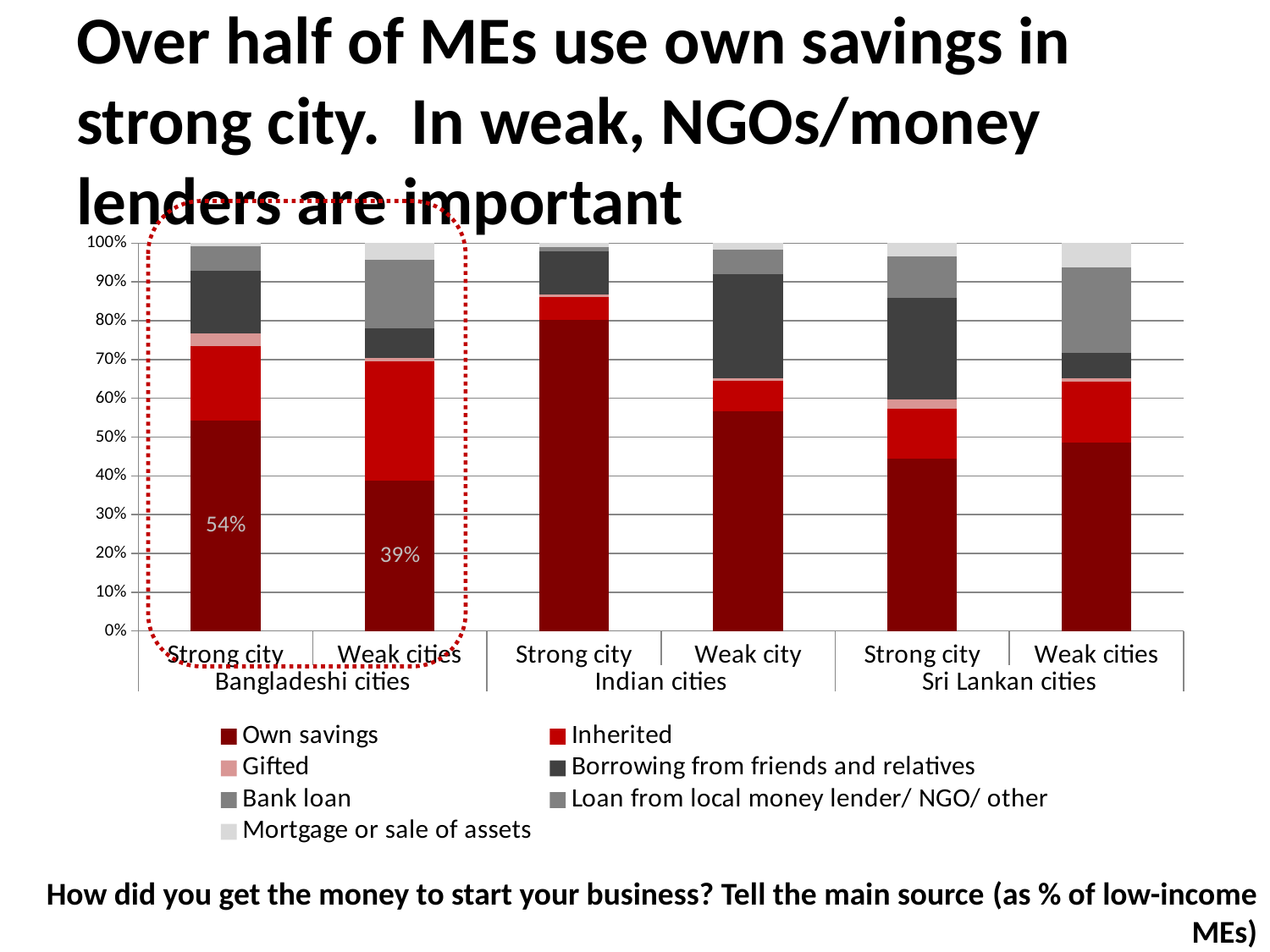
How many funding sources does the legend list? 7 Which city group has the largest own savings segment? Indian strong city By how many percentage points does the own savings share in the Bangladeshi strong city exceed that in the Bangladeshi weak cities? 15 percentage points How many stacked bars are plotted in the chart? 6 Which has a larger own savings share: the Bangladeshi strong city or the Bangladeshi weak cities? Strong city What kind of chart is shown on the slide? Stacked bar chart What percentage of MEs in the Bangladeshi weak cities used own savings to start their business? 39% Is the own savings share for the Indian strong city greater or less than 70%? greater What percentage of MEs in the Bangladeshi strong city used own savings to start their business? 54% Which country's bars are enclosed by the red dotted outline? Bangladeshi cities Is the own savings share for the Sri Lankan strong city greater or less than 50%? less Which city group has the smallest own savings segment? Bangladeshi weak cities